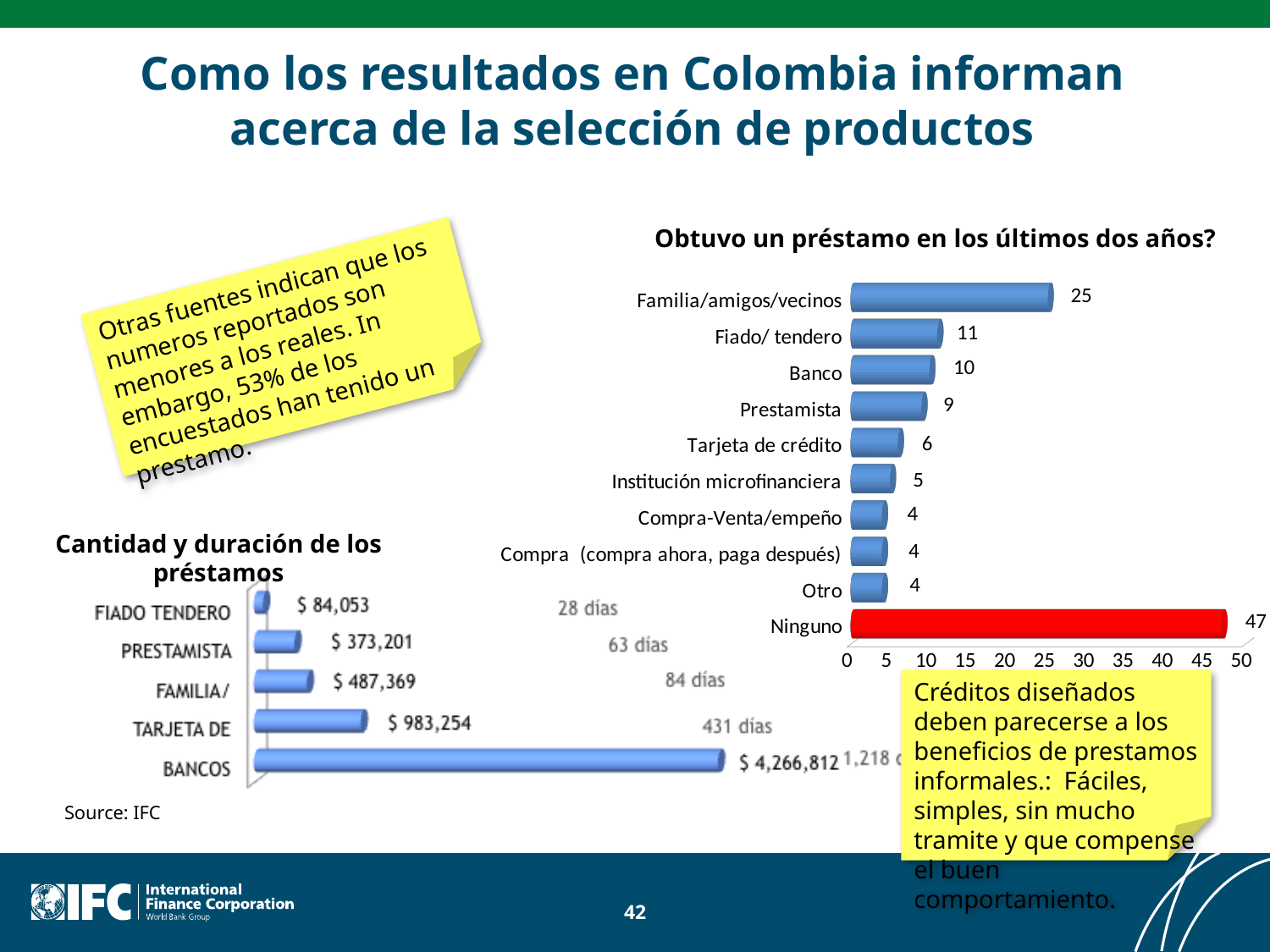
In the chart 'Obtuvo un préstamo en los últimos dos años?', which is larger, the value for Prestamista or the value for Tarjeta de crédito? Prestamista In the chart 'Obtuvo un préstamo en los últimos dos años?', what colour is the bar for Ninguno? Red In the chart 'Obtuvo un préstamo en los últimos dos años?', what is the value for Familia/amigos/vecinos? 25 In the chart 'Cantidad y duración de los préstamos', what is the amount shown for BANCOS? $ 4,266,812 In the chart 'Obtuvo un préstamo en los últimos dos años?', which category has the highest value? Ninguno In the chart 'Obtuvo un préstamo en los últimos dos años?', how many categories are shown? 10 In the chart 'Obtuvo un préstamo en los últimos dos años?', what is the value for Ninguno? 47 In the chart 'Cantidad y duración de los préstamos', how many días are shown for PRESTAMISTA? 63 días In the chart 'Cantidad y duración de los préstamos', which category has the lowest amount? FIADO TENDERO In the chart 'Obtuvo un préstamo en los últimos dos años?', what is the value for Institución microfinanciera? 5 In the chart 'Obtuvo un préstamo en los últimos dos años?', what is the difference between the values for Fiado/ tendero and Banco? 1 What kind of chart is 'Obtuvo un préstamo en los últimos dos años?'? Bar chart